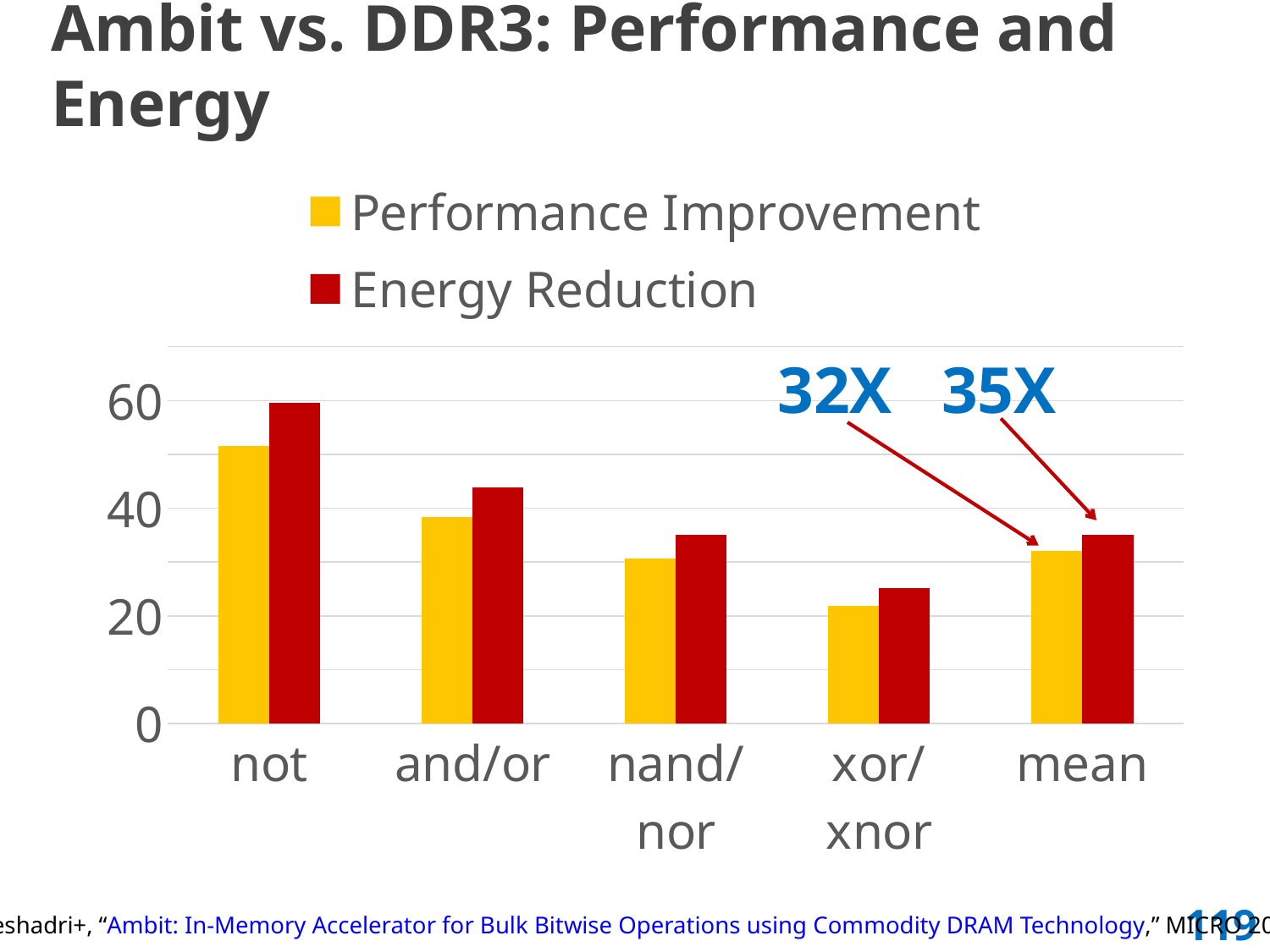
What is the mean Energy Reduction according to the annotation? 35X Do the Performance Improvement values rise or fall from not to xor/xnor? fall What is the difference between the mean Energy Reduction and the mean Performance Improvement? 3X Which category has the highest Energy Reduction? not What kind of chart is shown on the slide? bar chart How many categories are shown on the x axis? 5 What colour are the Energy Reduction bars? red How many series does the legend list? 2 Which category has the lowest Performance Improvement? xor/xnor What is the mean Performance Improvement according to the annotation? 32X Which has a larger Energy Reduction, not or and/or? not Is the Energy Reduction for not greater or less than 40? greater